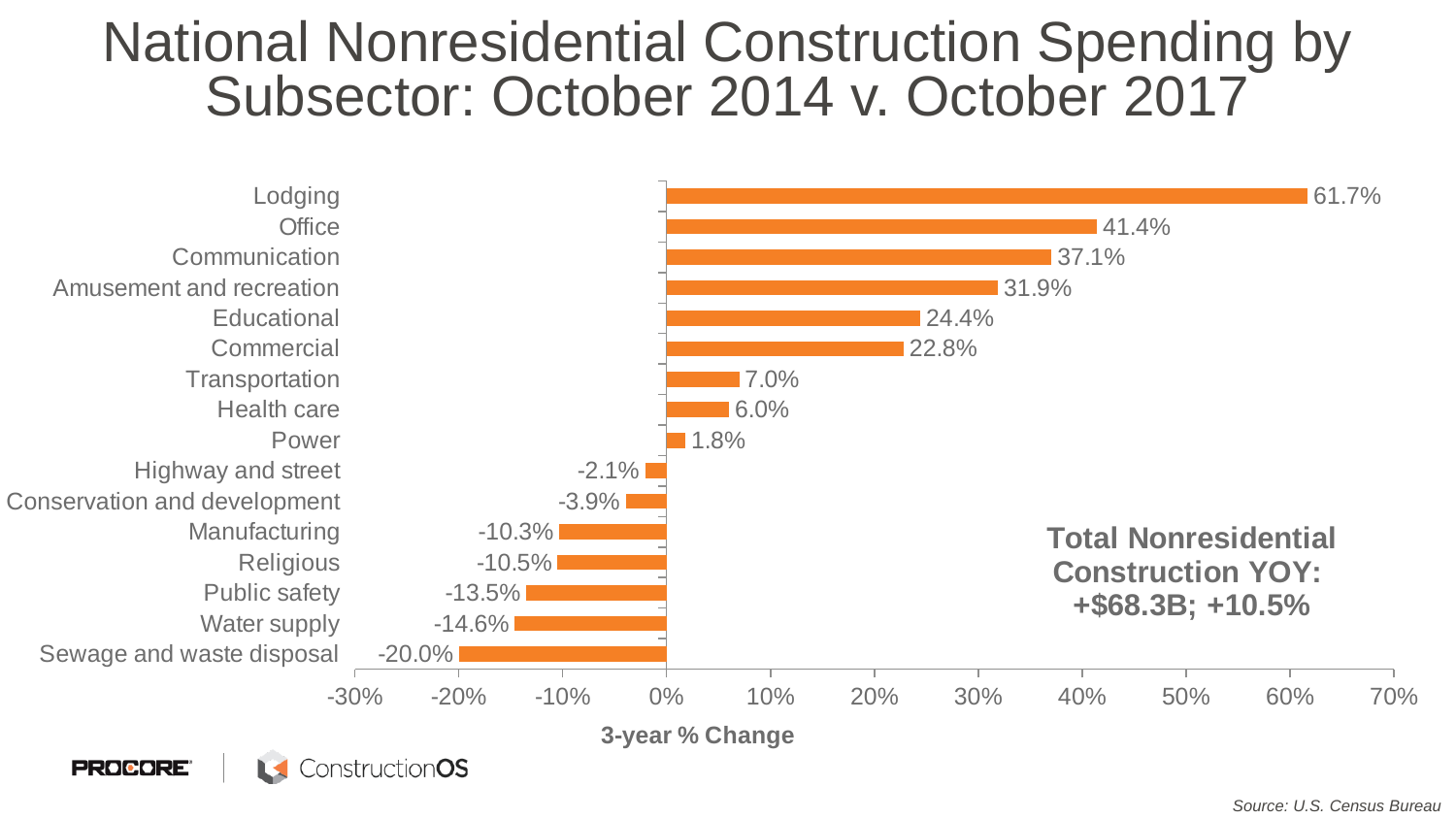
Is the value for Amusement and recreation greater or less than 30%? greater What is the 3-year % change for Health care? 6.0% What is the difference between the 3-year % change for Office and for Communication? 4.3% How many subsectors are shown in the chart? 16 Which has a larger 3-year % change, Educational or Commercial? Educational What kind of chart is shown on the slide? Bar chart What is the label on the horizontal axis of the chart? 3-year % Change Which subsector has the highest 3-year % change? Lodging What is the 3-year % change for Lodging? 61.7% What is the 3-year % change for Sewage and waste disposal? -20.0% Which subsector has the lowest 3-year % change? Sewage and waste disposal What is the 3-year % change for Religious? -10.5%